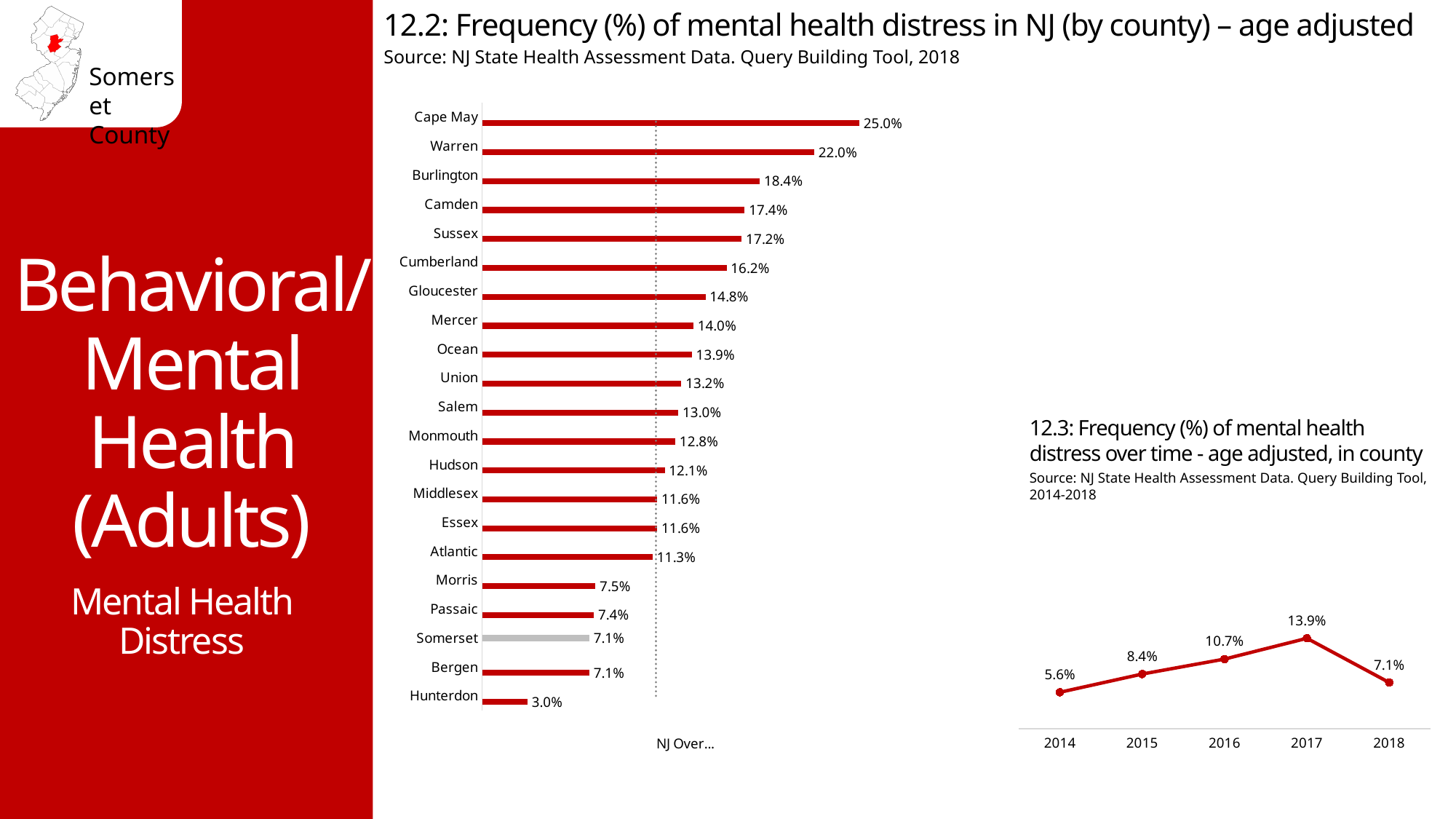
In the chart '12.2: Frequency (%) of mental health distress in NJ (by county) – age adjusted', which county has the lowest value? Hunterdon In the chart '12.3: Frequency (%) of mental health distress over time - age adjusted, in county', what is the difference between the values for 2017 and 2018? 6.8% What kind of chart is '12.3: Frequency (%) of mental health distress over time - age adjusted, in county'? Line chart In the chart '12.3: Frequency (%) of mental health distress over time - age adjusted, in county', what is the value for 2017? 13.9% In the chart '12.2: Frequency (%) of mental health distress in NJ (by county) – age adjusted', what is the value for Somerset? 7.1% In the chart '12.2: Frequency (%) of mental health distress in NJ (by county) – age adjusted', what is the value for Mercer? 14.0% In the chart '12.3: Frequency (%) of mental health distress over time - age adjusted, in county', which year has the lowest value? 2014 What kind of chart is '12.2: Frequency (%) of mental health distress in NJ (by county) – age adjusted'? Bar chart In the chart '12.2: Frequency (%) of mental health distress in NJ (by county) – age adjusted', how many counties are shown? 21 In the chart '12.2: Frequency (%) of mental health distress in NJ (by county) – age adjusted', which county has the highest value? Cape May In the chart '12.2: Frequency (%) of mental health distress in NJ (by county) – age adjusted', what is the difference between the values for Cape May and Warren? 3.0% In the chart '12.2: Frequency (%) of mental health distress in NJ (by county) – age adjusted', which is larger, the value for Camden or the value for Gloucester? Camden